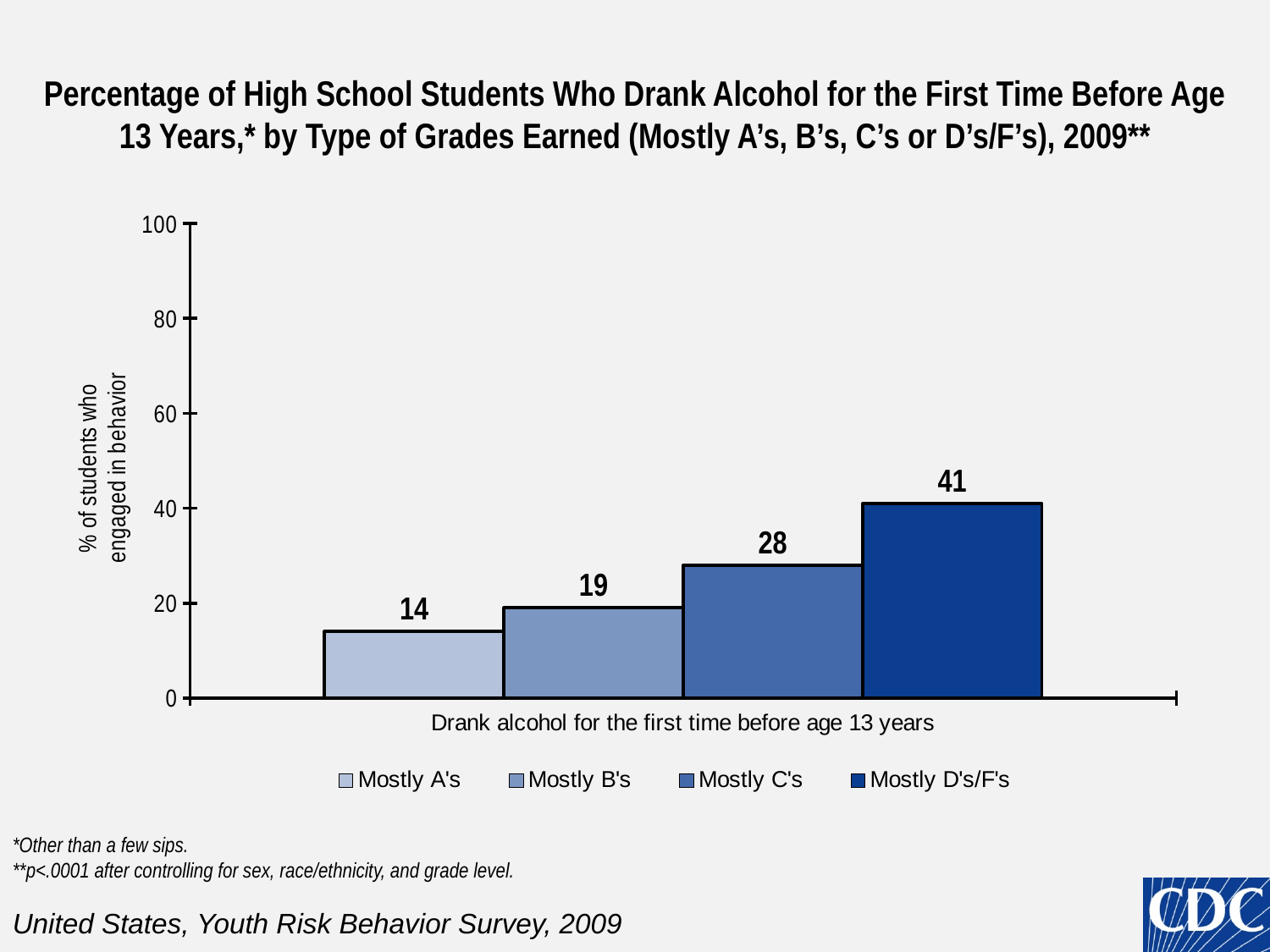
What is the difference between the values for mostly D's/F's and mostly A's? 27 Which grade group has the highest percentage of students who drank alcohol for the first time before age 13? Mostly D's/F's What is the value shown for students who earned mostly B's? 19 What percentage of students who earned mostly A's drank alcohol for the first time before age 13 years? 14 What kind of chart is shown on the slide? Bar chart What is the label on the y axis of the chart? % of students who engaged in behavior Which grade group has the lowest percentage of students who drank alcohol for the first time before age 13? Mostly A's How many series does the legend list? 4 What is the value shown for students who earned mostly D's/F's? 41 Which is larger, the value for mostly B's or the value for mostly C's? Mostly C's Is the value for mostly D's/F's greater or less than 40? greater What is the value shown for students who earned mostly C's? 28